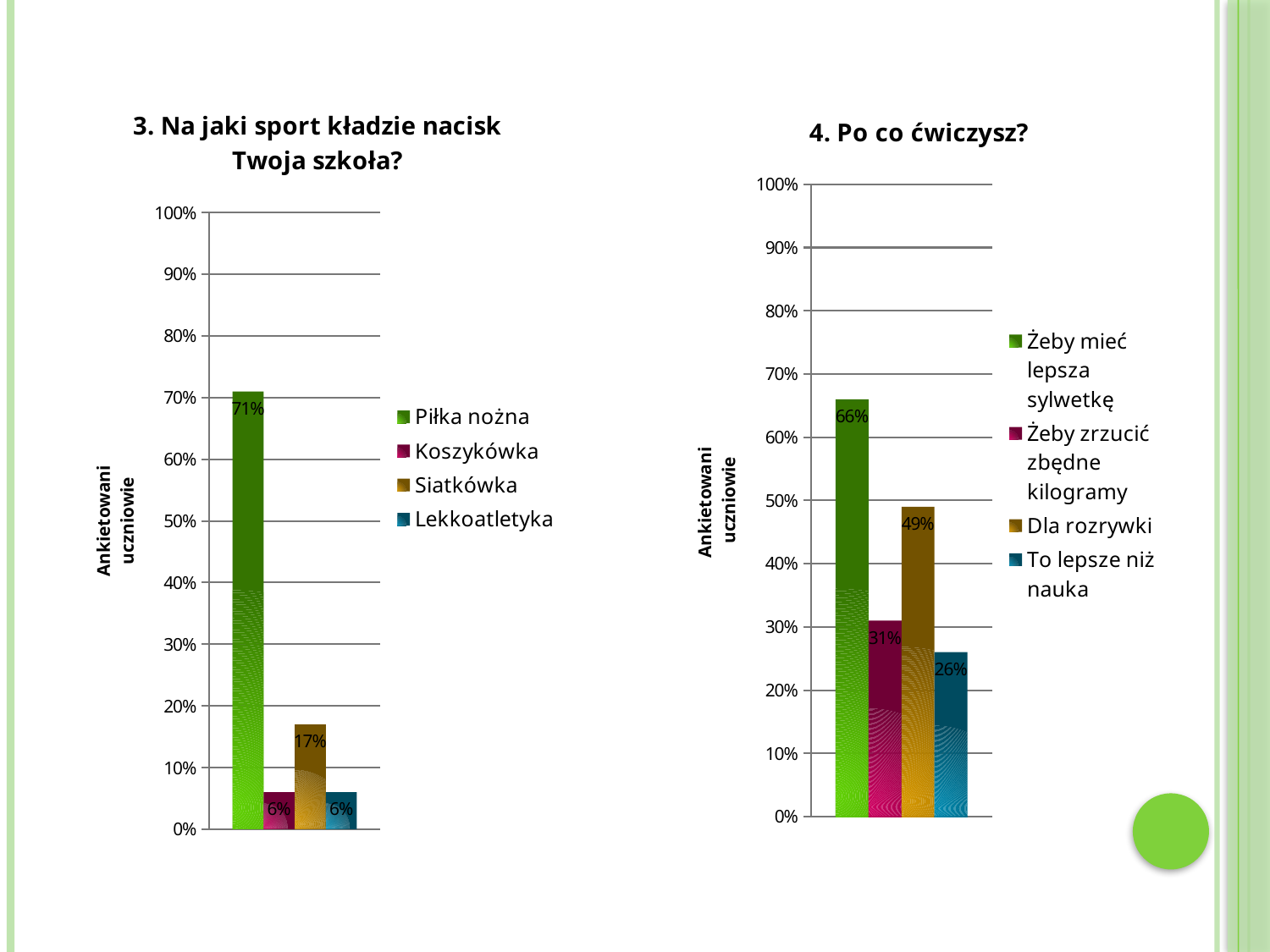
In the chart titled "4. Po co ćwiczysz?", what is the value for To lepsze niż nauka? 26% In the chart titled "3. Na jaki sport kładzie nacisk Twoja szkoła?", what is the value for Koszykówka? 6% In the chart titled "4. Po co ćwiczysz?", which is larger: Żeby zrzucić zbędne kilogramy or Dla rozrywki? Dla rozrywki In the chart titled "3. Na jaki sport kładzie nacisk Twoja szkoła?", what is the value for Siatkówka? 17% In the chart titled "3. Na jaki sport kładzie nacisk Twoja szkoła?", how many series does the legend list? 4 In the chart titled "4. Po co ćwiczysz?", which series has the lowest value? To lepsze niż nauka In the chart titled "3. Na jaki sport kładzie nacisk Twoja szkoła?", what is the difference between Piłka nożna and Siatkówka? 54% In the chart titled "3. Na jaki sport kładzie nacisk Twoja szkoła?", which series has the highest value? Piłka nożna In the chart titled "4. Po co ćwiczysz?", what is the difference between Żeby mieć lepsza sylwetkę and Żeby zrzucić zbędne kilogramy? 35% In the chart titled "4. Po co ćwiczysz?", what is the value for Dla rozrywki? 49% What kind of chart is the chart titled "4. Po co ćwiczysz?"? Bar chart In the chart titled "3. Na jaki sport kładzie nacisk Twoja szkoła?", what is the value for Piłka nożna? 71%